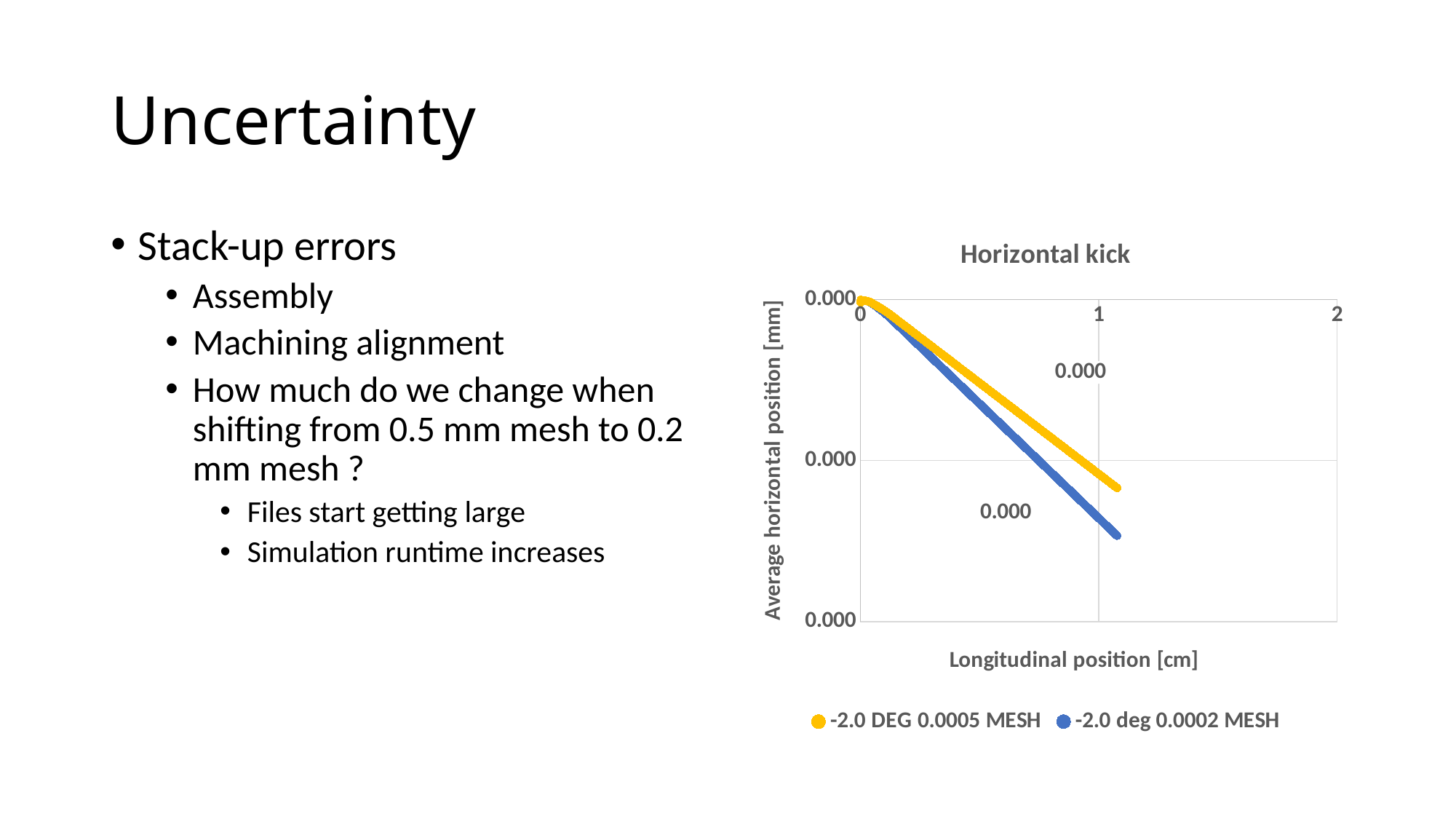
What kind of chart is the "Horizontal kick" chart? scatter chart In the "Horizontal kick" chart, which series has the lower average horizontal position at the right end of the plotted data? -2.0 deg 0.0002 MESH In the "Horizontal kick" chart, which series declines more steeply with longitudinal position? -2.0 deg 0.0002 MESH What is the title of the chart on the slide? Horizontal kick In the "Horizontal kick" chart, which series is plotted in blue? -2.0 deg 0.0002 MESH What is the x-axis label of the "Horizontal kick" chart? Longitudinal position [cm] How many series does the legend of the "Horizontal kick" chart list? 2 In the "Horizontal kick" chart, do the values of the -2.0 DEG 0.0005 MESH series rise or fall as longitudinal position increases? fall In the "Horizontal kick" chart, do the values of the -2.0 deg 0.0002 MESH series rise or fall as longitudinal position increases? fall